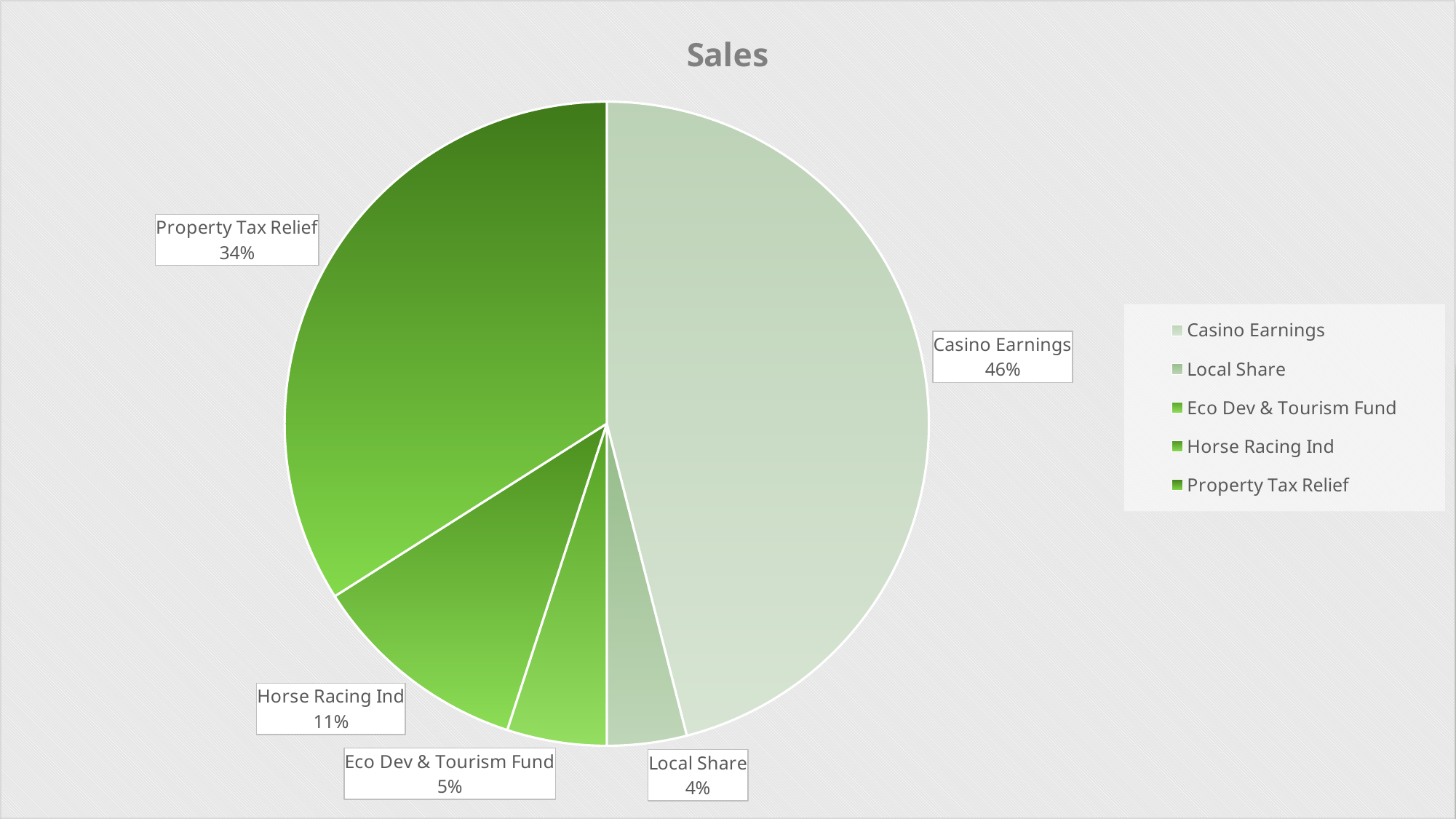
What percentage is shown for Horse Racing Ind? 11% What is the title of the chart? Sales What type of chart is shown on the slide? pie chart How many categories does the legend list? 5 What percentage is shown for Property Tax Relief? 34% What percentage is shown for Local Share? 4% What share of the pie does Casino Earnings represent? 46% Which category has the smallest share of the pie? Local Share What percentage is shown for Eco Dev & Tourism Fund? 5% Which category has the largest share of the pie? Casino Earnings Which is larger, Horse Racing Ind or Eco Dev & Tourism Fund? Horse Racing Ind What is the difference in percentage points between Casino Earnings and Property Tax Relief? 12